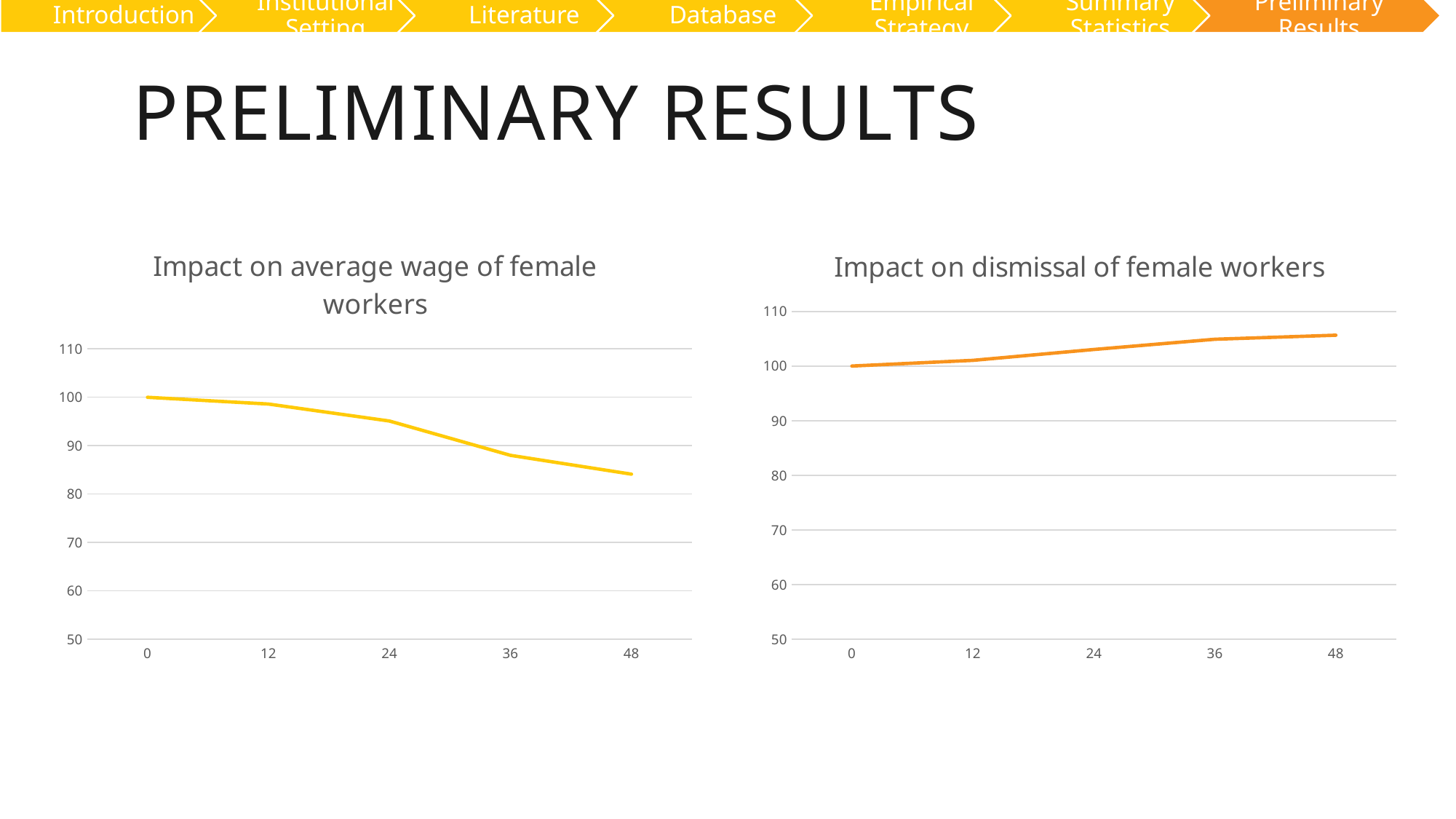
In the 'Impact on dismissal of female workers' chart, is the value at 48 greater or less than 110? less In the 'Impact on dismissal of female workers' chart, is the value at 48 greater or less than 100? greater In the 'Impact on average wage of female workers' chart, is the value at 48 greater or less than 90? less How many points are plotted on the 'Impact on dismissal of female workers' chart? 5 In the 'Impact on dismissal of female workers' chart, at which x value is the line highest? 48 What kind of chart is the 'Impact on average wage of female workers' chart? line chart In the 'Impact on average wage of female workers' chart, at which x value is the line lowest? 48 In the 'Impact on average wage of female workers' chart, what is the value at 0? 100 In the 'Impact on dismissal of female workers' chart, what is the value at 0? 100 In the 'Impact on dismissal of female workers' chart, do the values rise or fall along the x axis? rise In the 'Impact on average wage of female workers' chart, do the values rise or fall along the x axis? fall